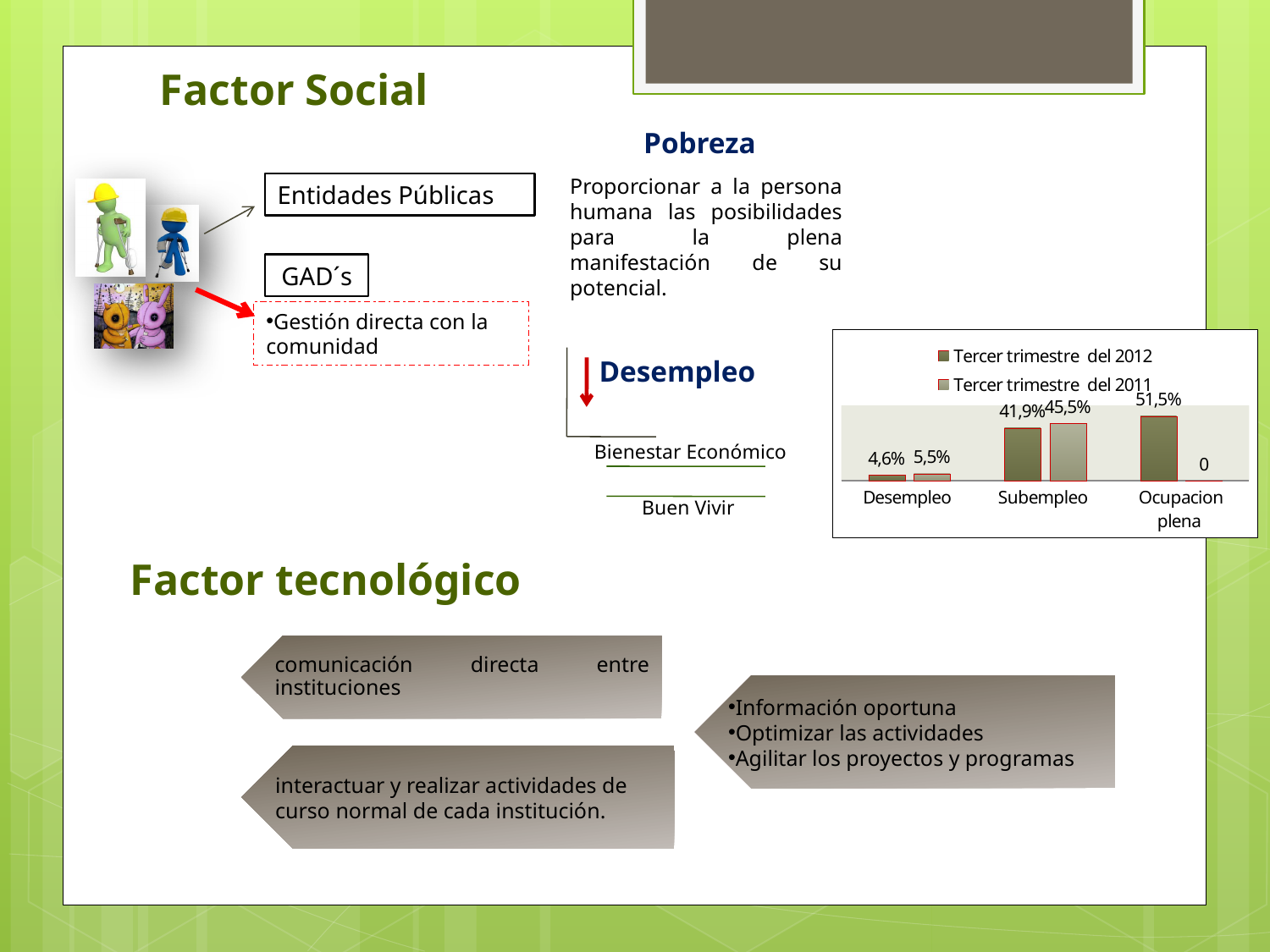
Which category has the highest value in the Tercer trimestre del 2012 series? Ocupacion plena How many series does the chart legend list? 2 What is the value for Ocupacion plena in the Tercer trimestre del 2012 series? 51,5% What kind of chart is shown on the slide? bar chart What is the value for Desempleo in the Tercer trimestre del 2011 series? 5,5% How many categories are shown on the chart's x axis? 3 What is the difference between the Tercer trimestre del 2011 and Tercer trimestre del 2012 values for Subempleo? 3,6% What is the value for Subempleo in the Tercer trimestre del 2012 series? 41,9% What is the value for Desempleo in the Tercer trimestre del 2012 series? 4,6% For Desempleo, which series has the larger value, Tercer trimestre del 2012 or Tercer trimestre del 2011? Tercer trimestre del 2011 What is the value for Subempleo in the Tercer trimestre del 2011 series? 45,5% Which category has the lowest value in the Tercer trimestre del 2011 series? Ocupacion plena